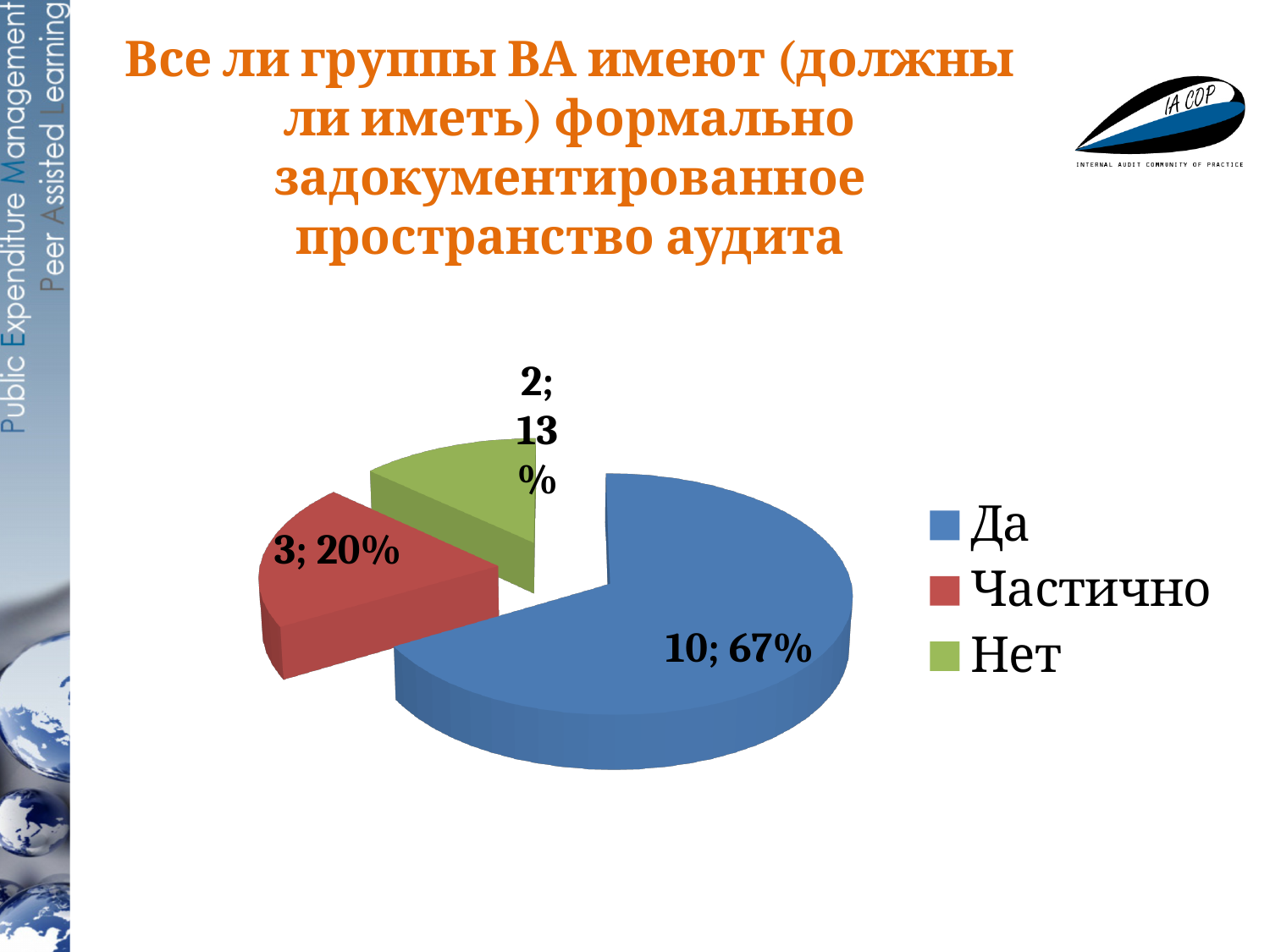
What is the count for the "Да" slice? 10 How many slices does the pie chart have? 3 What kind of chart is shown on the slide? pie chart Which category has the smallest slice? Нет What is the count for the "Частично" slice? 3 What share of the pie does the "Частично" slice represent? 20% Which colour represents the "Нет" category in the legend? green What is the difference between the counts for "Да" and "Частично"? 7 How many entries does the legend list? 3 What is the count for the "Нет" slice? 2 Which category has the largest slice? Да What share of the pie does the "Да" slice represent? 67%